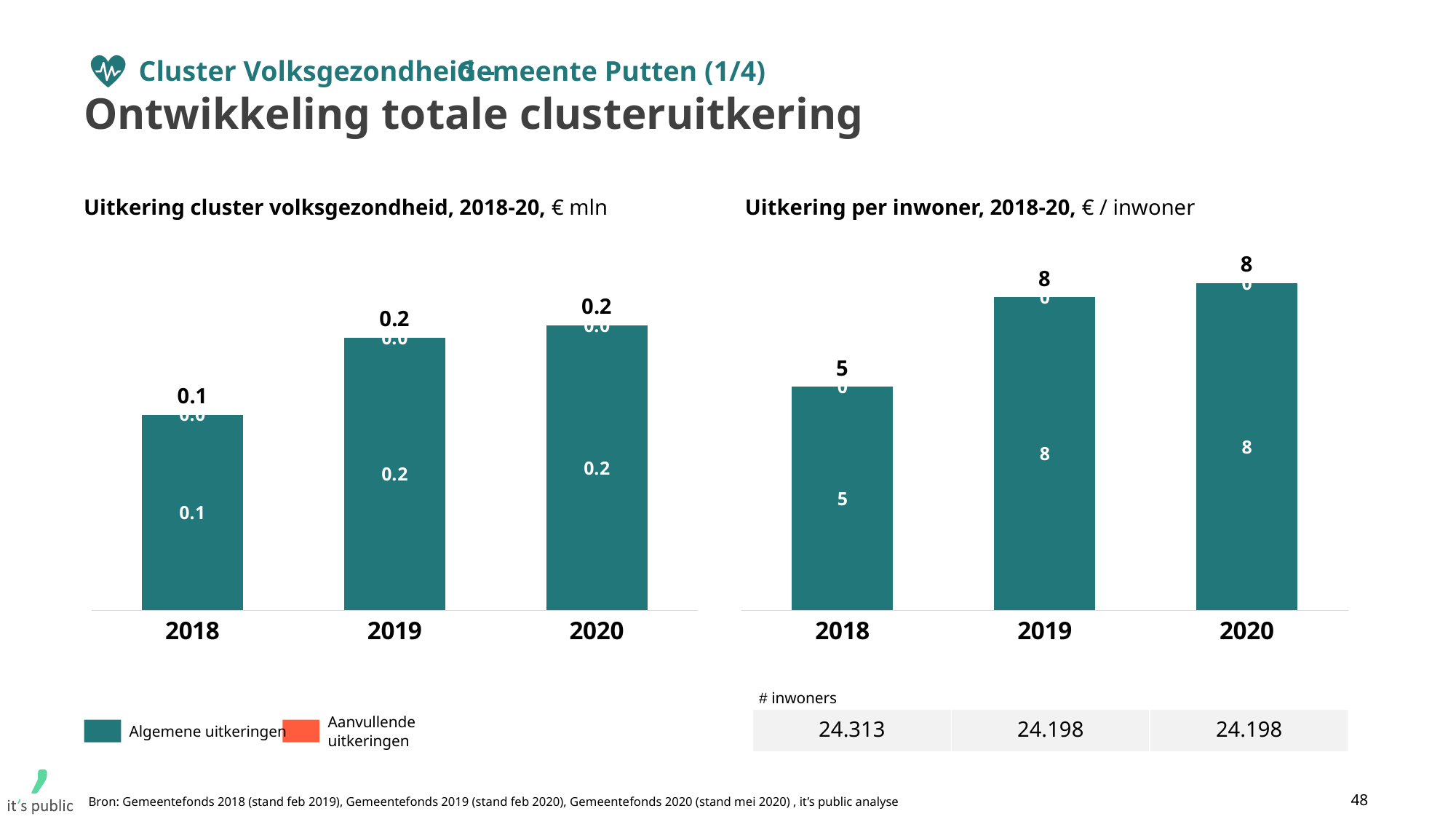
In the right chart 'Uitkering per inwoner, 2018-20', what is the total value shown above the bar for 2019? 8 What kind of chart is the left chart 'Uitkering cluster volksgezondheid, 2018-20'? Stacked bar chart In the right chart 'Uitkering per inwoner, 2018-20', do the totals rise or fall from 2018 to 2019? Rise In the left chart 'Uitkering cluster volksgezondheid, 2018-20', what is the total value shown above the bar for 2018? 0.1 In the left chart 'Uitkering cluster volksgezondheid, 2018-20', what is the total value shown above the bar for 2020? 0.2 In the right chart 'Uitkering per inwoner, 2018-20', what is the difference between the total for 2019 and the total for 2018? 3 In the right chart 'Uitkering per inwoner, 2018-20', is the total for 2018 larger or smaller than the total for 2020? Smaller How many series does the legend of the left chart 'Uitkering cluster volksgezondheid, 2018-20' list? 2 In the left chart 'Uitkering cluster volksgezondheid, 2018-20', what is the value of Algemene uitkeringen for 2019? 0.2 In the left chart 'Uitkering cluster volksgezondheid, 2018-20', which year has the lowest total? 2018 How many years are shown on the x axis of the right chart 'Uitkering per inwoner, 2018-20'? 3 In the right chart 'Uitkering per inwoner, 2018-20', what is the total value shown above the bar for 2018? 5